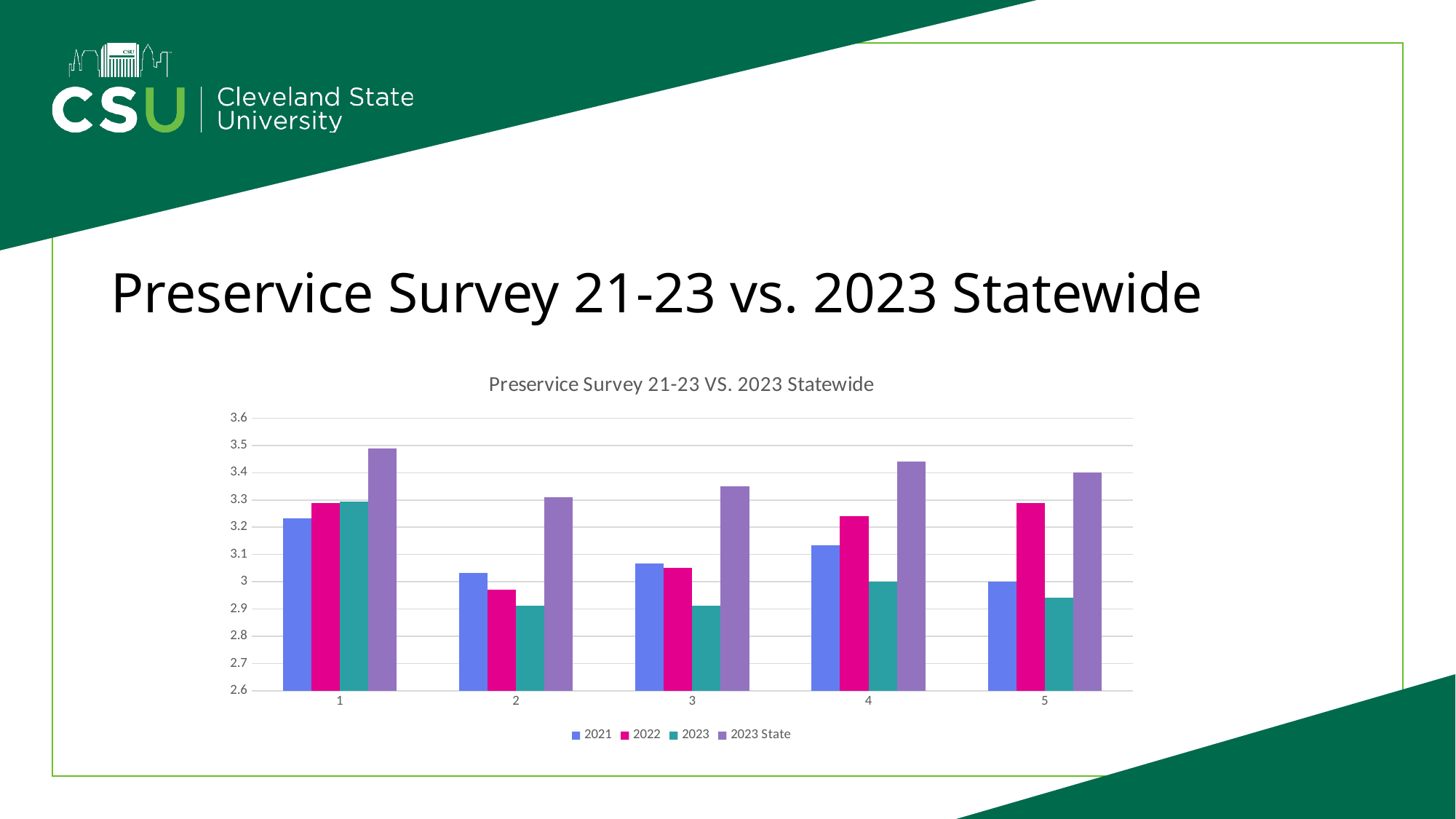
What is the title of the chart? Preservice Survey 21-23 VS. 2023 Statewide Is the value for 2022 at category 5 greater or less than 3.2? greater Is the value for 2023 State at category 1 greater or less than 3.4? greater Which series is shown in magenta/pink in the legend? 2022 Is the value for 2023 at category 2 greater or less than 3? less For the 2023 State series, which category has the lowest value? 2 At category 2, which is larger: the 2021 value or the 2022 value? 2021 Which series has the highest value at category 1? 2023 State How many series does the legend list? 4 How many categories are shown on the x axis? 5 For the 2021 series, which category has the highest value? 1 What kind of chart is shown on the slide? bar chart